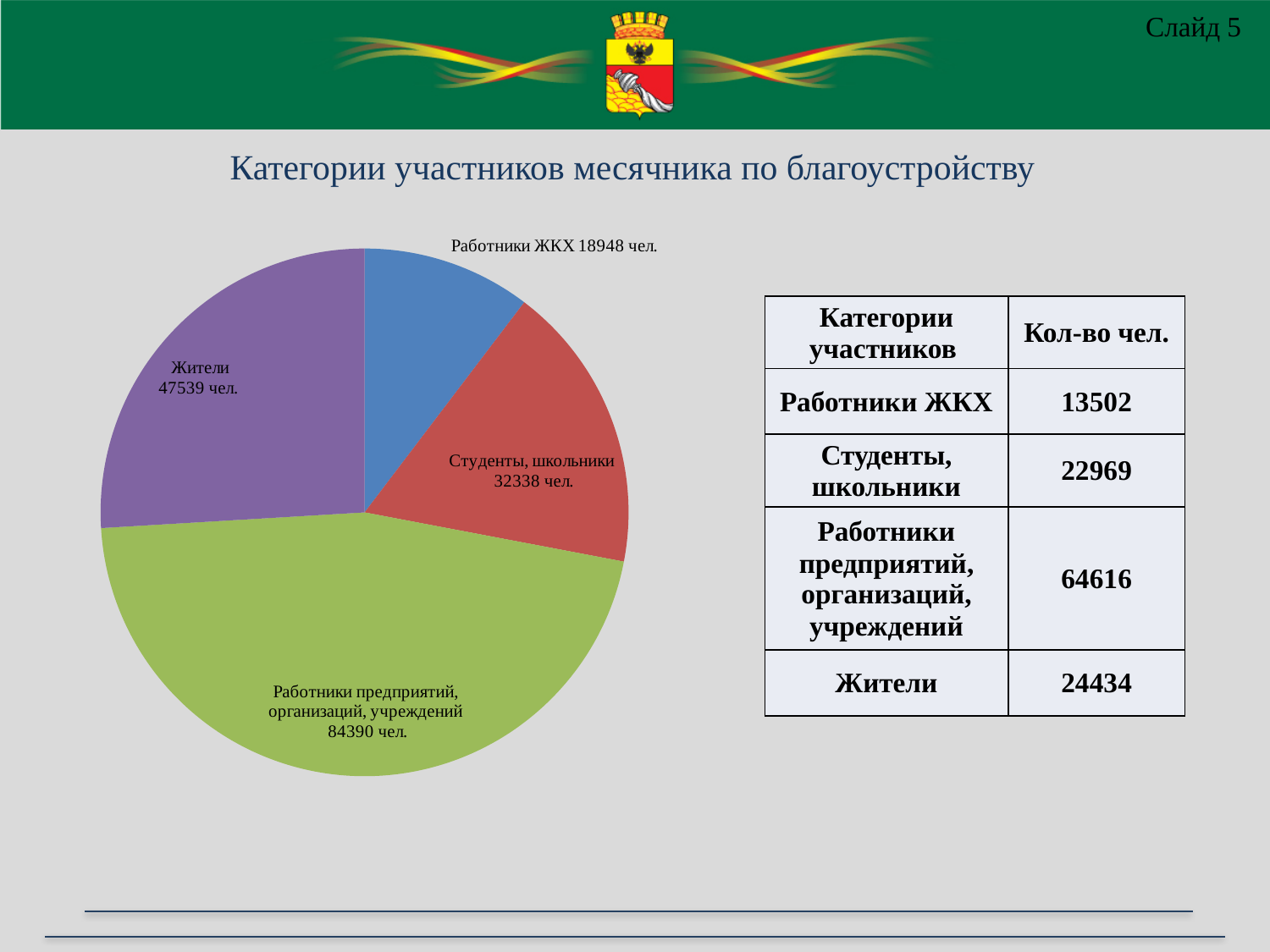
Based on the pie chart labels, what is the difference between 'Студенты, школьники' and 'Работники ЖКХ'? 13390 Which category has the smallest slice in the pie chart? Работники ЖКХ In the pie chart, which is larger: 'Жители' or 'Студенты, школьники'? Жители According to the pie chart's data label, how many people are in the 'Студенты, школьники' category? 32338 чел. According to the pie chart's data label, how many people are in the 'Работники ЖКХ' category? 18948 чел. According to the pie chart's data label, how many people are in the 'Работники предприятий, организаций, учреждений' category? 84390 чел. What is the title of the slide above the pie chart? Категории участников месячника по благоустройству Which category has the largest slice in the pie chart? Работники предприятий, организаций, учреждений How many categories (slices) does the pie chart have? 4 What type of chart is shown on the slide? Pie chart According to the pie chart's data label, how many people are in the 'Жители' category? 47539 чел. Based on the pie chart labels, what is the difference between 'Работники предприятий, организаций, учреждений' and 'Жители'? 36851